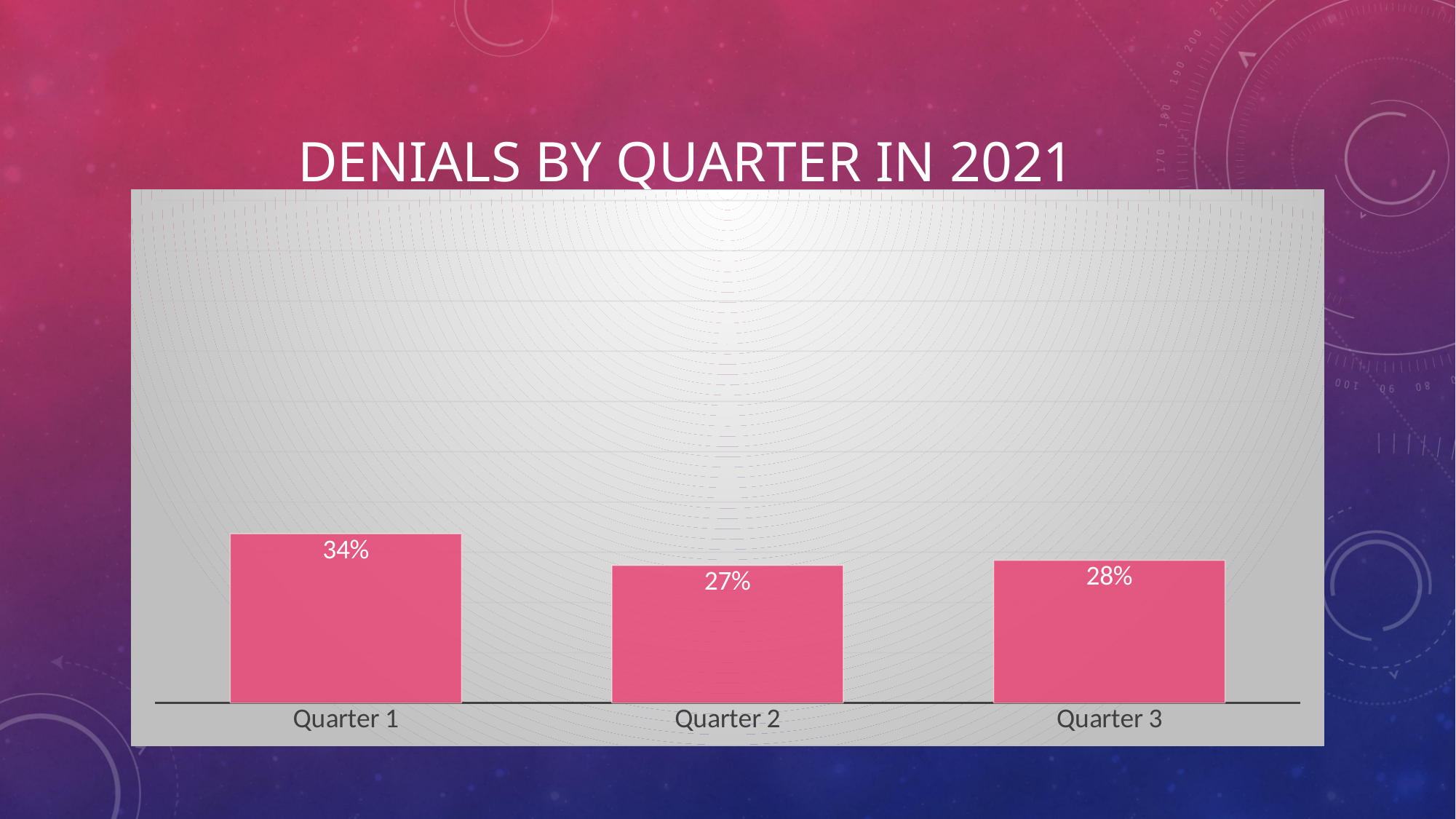
What kind of chart is shown on the slide? Bar chart Which quarter has the highest value? Quarter 1 How many quarters are shown in the chart? 3 Does the value rise or fall from Quarter 1 to Quarter 2? Fall What is the value for Quarter 2? 27% Which is larger, the value for Quarter 1 or the value for Quarter 3? Quarter 1 What is the value for Quarter 3? 28% Which quarter has the lowest value? Quarter 2 What is the title of the chart? Denials by Quarter in 2021 What is the difference between the values for Quarter 3 and Quarter 2? 1% What is the value for Quarter 1? 34% What is the difference between the values for Quarter 1 and Quarter 2? 7%